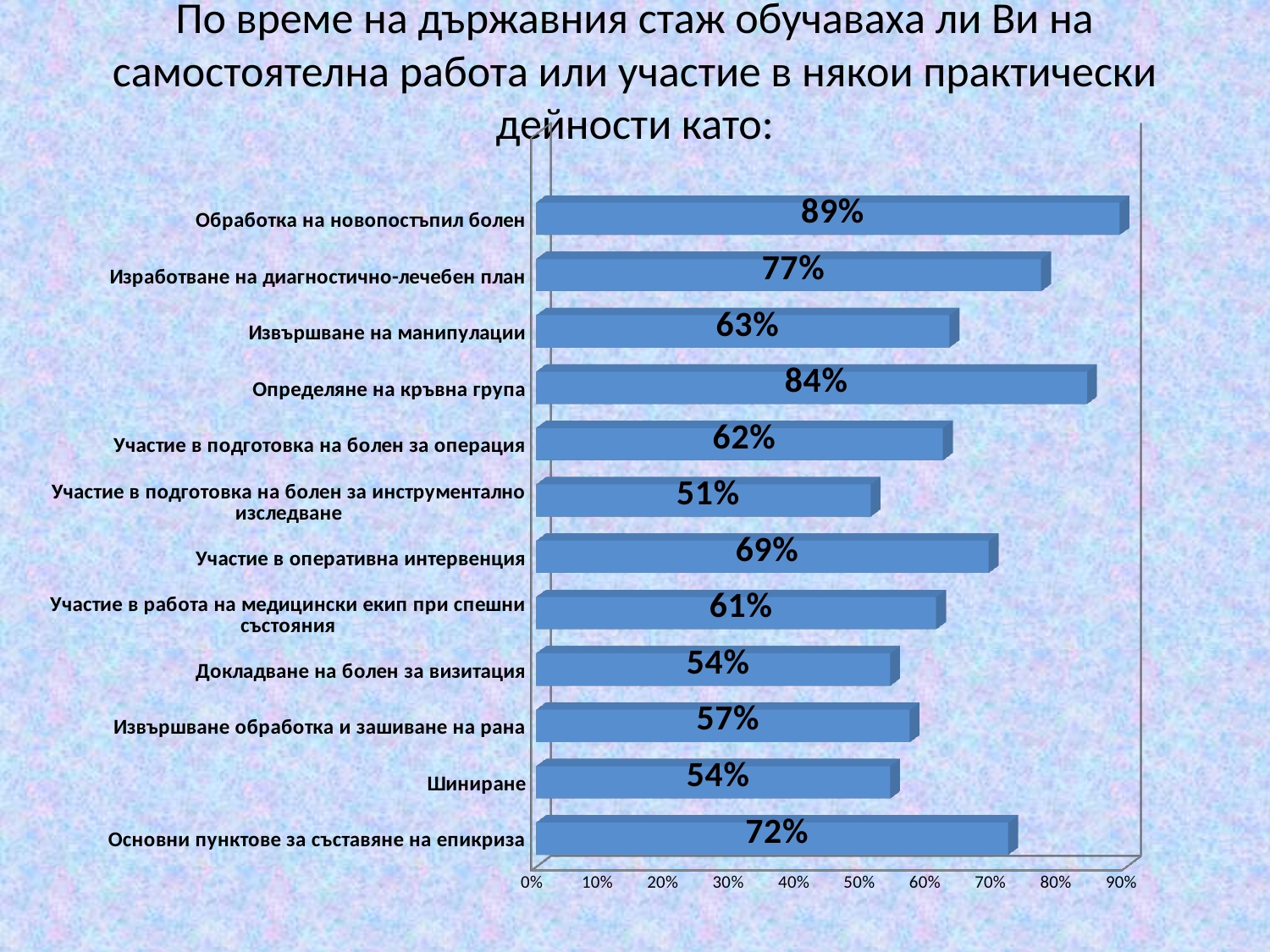
What is the difference between the values for "Обработка на новопостъпил болен" and "Изработване на диагностично-лечебен план"? 12 percentage points What is the difference between the values for "Извършване обработка и зашиване на рана" and "Докладване на болен за визитация"? 3 percentage points Which category has the highest value? Обработка на новопостъпил болен What kind of chart is shown on the slide? Bar chart How many categories are shown in the chart? 12 Is the value for "Участие в оперативна интервенция" greater or less than 60%? greater What is the value for "Шиниране"? 54% Which is larger: the value for "Определяне на кръвна група" or for "Изработване на диагностично-лечебен план"? Определяне на кръвна група What is the value for "Основни пунктове за съставяне на епикриза"? 72% What is the value for "Определяне на кръвна група"? 84% Which category has the lowest value? Участие в подготовка на болен за инструментално изследване What is the value for "Обработка на новопостъпил болен"? 89%